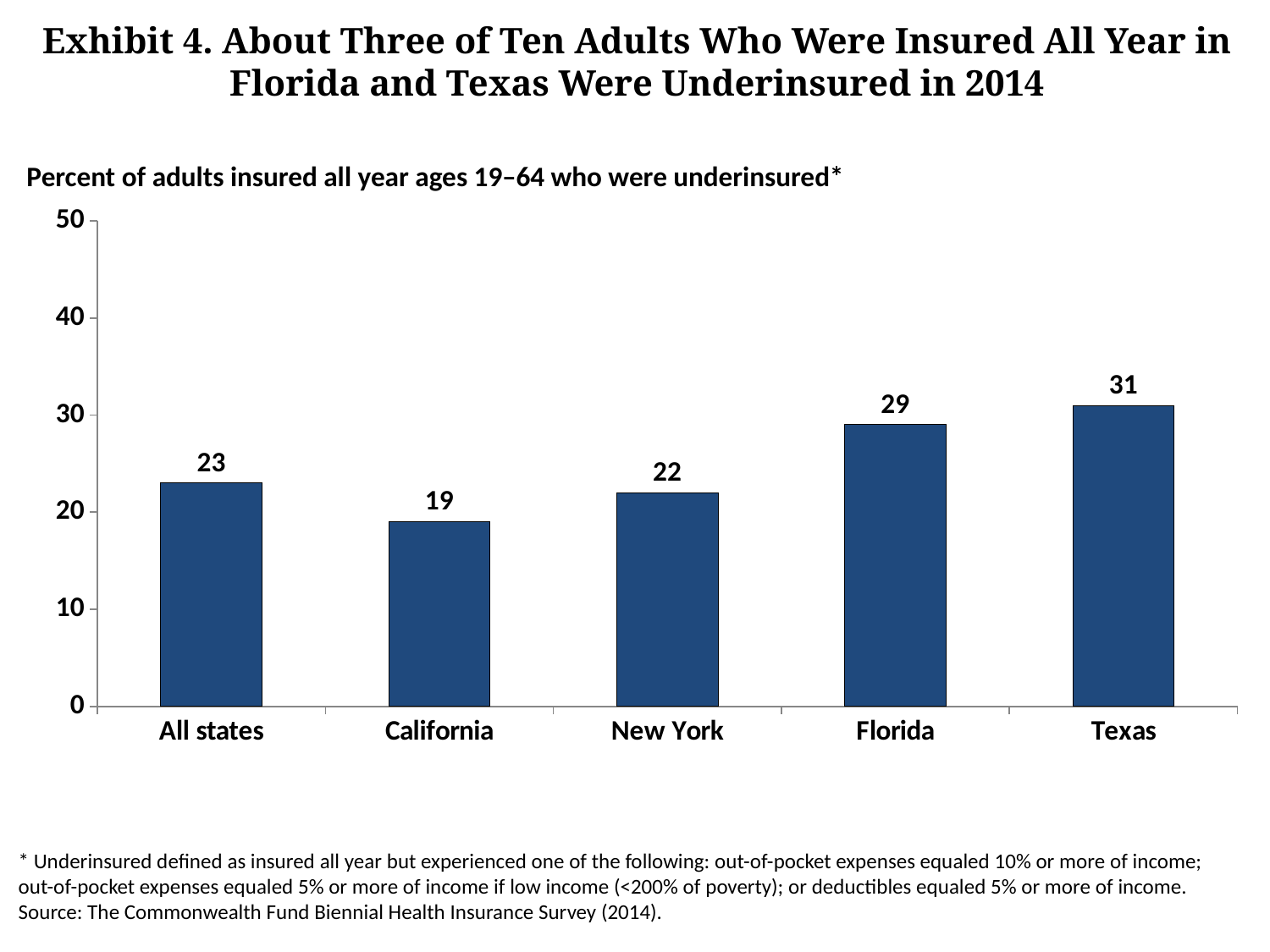
What is the value for California? 19 What is the value for All states? 23 How many categories are shown on the x axis? 5 What is the difference between the values for Florida and New York? 7 What is the label above the chart describing what is plotted? Percent of adults insured all year ages 19–64 who were underinsured* What is the value for Texas? 31 Which is larger, the value for Florida or the value for All states? Florida Which category has the highest value? Texas What kind of chart is shown on the slide? bar chart Which category has the lowest value? California What is the difference between the values for Texas and California? 12 Is the value for New York greater or less than 30? less